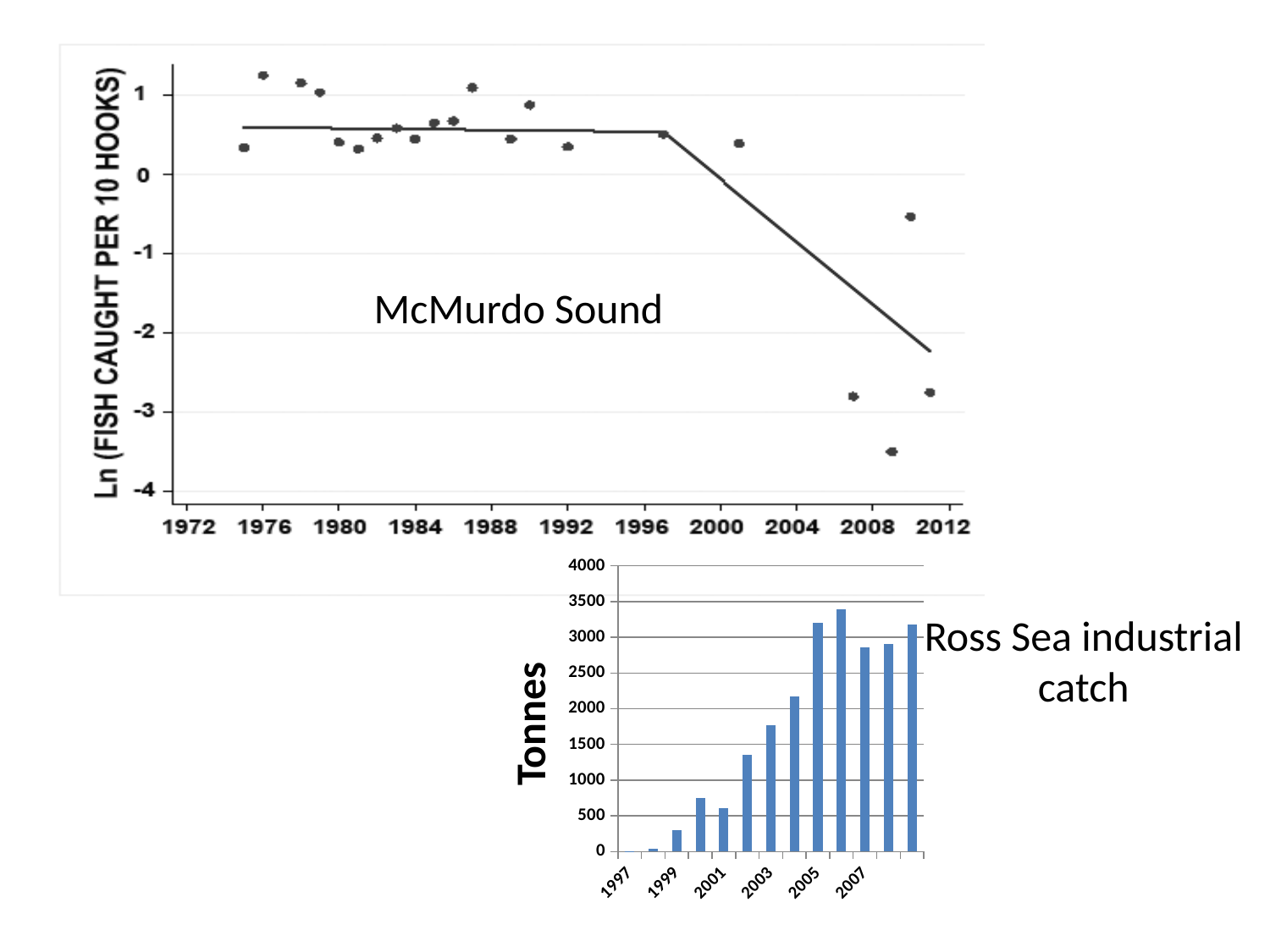
In the Ross Sea industrial catch chart, which is larger, the value for 2003 or the value for 2005? 2005 What kind of chart is the McMurdo Sound chart? scatter plot In the Ross Sea industrial catch chart, what is the y-axis label? Tonnes In the Ross Sea industrial catch chart, do the values generally rise or fall from 1997 to 2005? rise In the Ross Sea industrial catch chart, is the value for 1999 greater or less than 500? less In the McMurdo Sound chart, what is the y-axis label? Ln (FISH CAUGHT PER 10 HOOKS) What kind of chart is the Ross Sea industrial catch chart? bar chart In the McMurdo Sound chart, does the fitted line rise or fall after about 1997? fall In the Ross Sea industrial catch chart, is the value for 2005 greater or less than 3000? greater In the Ross Sea industrial catch chart, is the value for 2003 greater or less than 2000? less